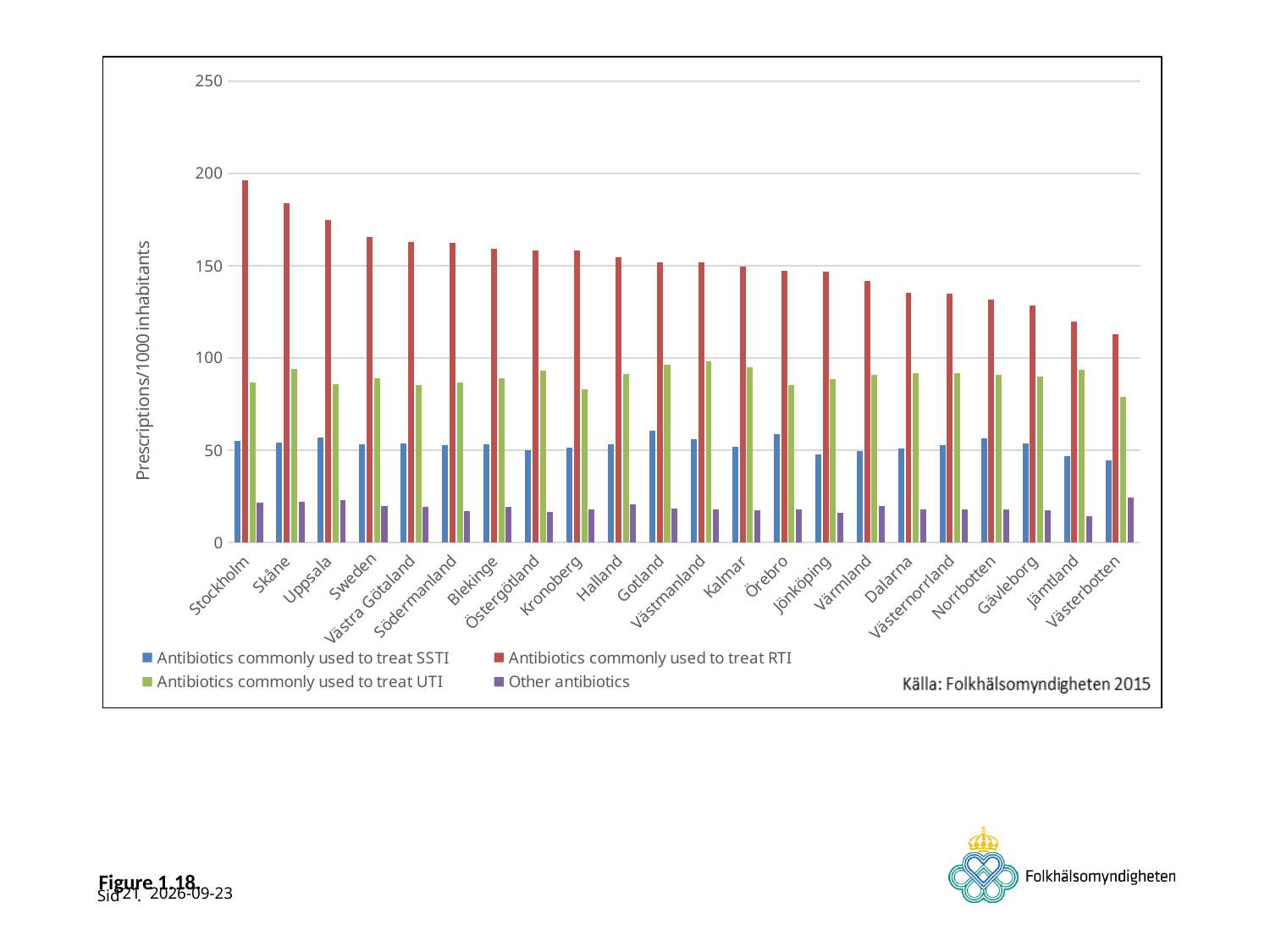
How many series does the legend list? 4 Is the value for Antibiotics commonly used to treat UTI in Västerbotten greater or less than 100? less Is the value for Antibiotics commonly used to treat RTI in Västerbotten greater or less than 100? greater Is the value for Other antibiotics in Stockholm greater or less than 50? less Which is larger, the value for Antibiotics commonly used to treat RTI in Stockholm or in Skåne? Stockholm What kind of chart is shown on the slide? bar chart What is the label on the y axis? Prescriptions/1000 inhabitants Which category has the lowest value for Antibiotics commonly used to treat RTI? Västerbotten Which category has the highest value for Antibiotics commonly used to treat RTI? Stockholm Do the values for Antibiotics commonly used to treat RTI rise or fall from left to right along the x axis? fall How many categories are shown along the x axis? 22